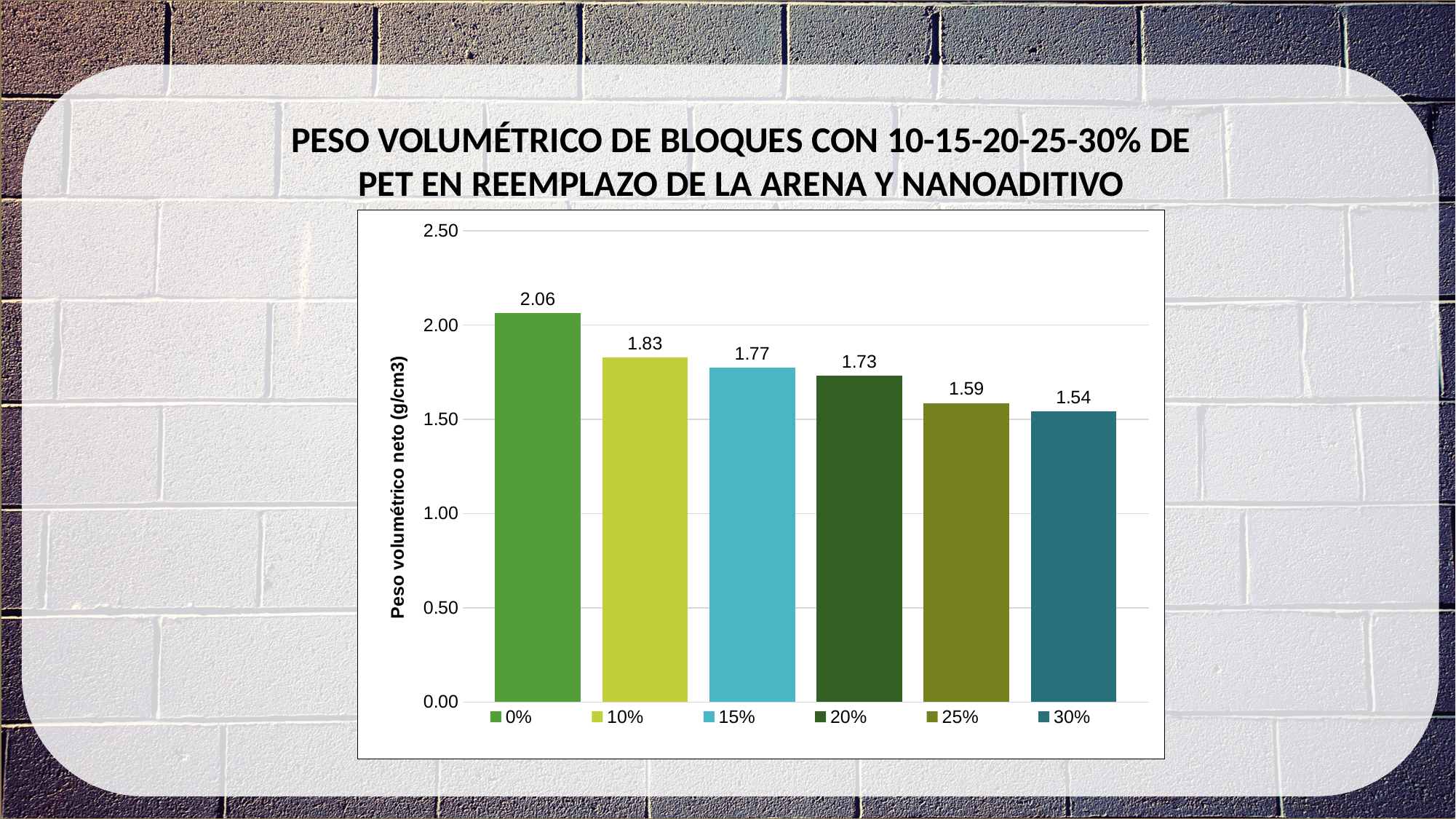
What is the difference in net volumetric weight between the 0% and 30% PET blocks? 0.52 What is the net volumetric weight for the 30% PET block? 1.54 What kind of chart is shown on the slide? Bar chart Which PET percentage has the lowest net volumetric weight? 30% What is the difference in net volumetric weight between the 10% and 20% PET blocks? 0.10 What is the net volumetric weight for the 0% PET block? 2.06 Is the value for the 20% PET block greater or less than 1.50? greater How many PET percentage categories are shown in the chart? 6 Do the net volumetric weight values rise or fall as the PET percentage increases from 0% to 30%? Fall What is the net volumetric weight for the 15% PET block? 1.77 Which has a larger net volumetric weight, the 10% or the 25% PET block? 10% Which PET percentage has the highest net volumetric weight? 0%